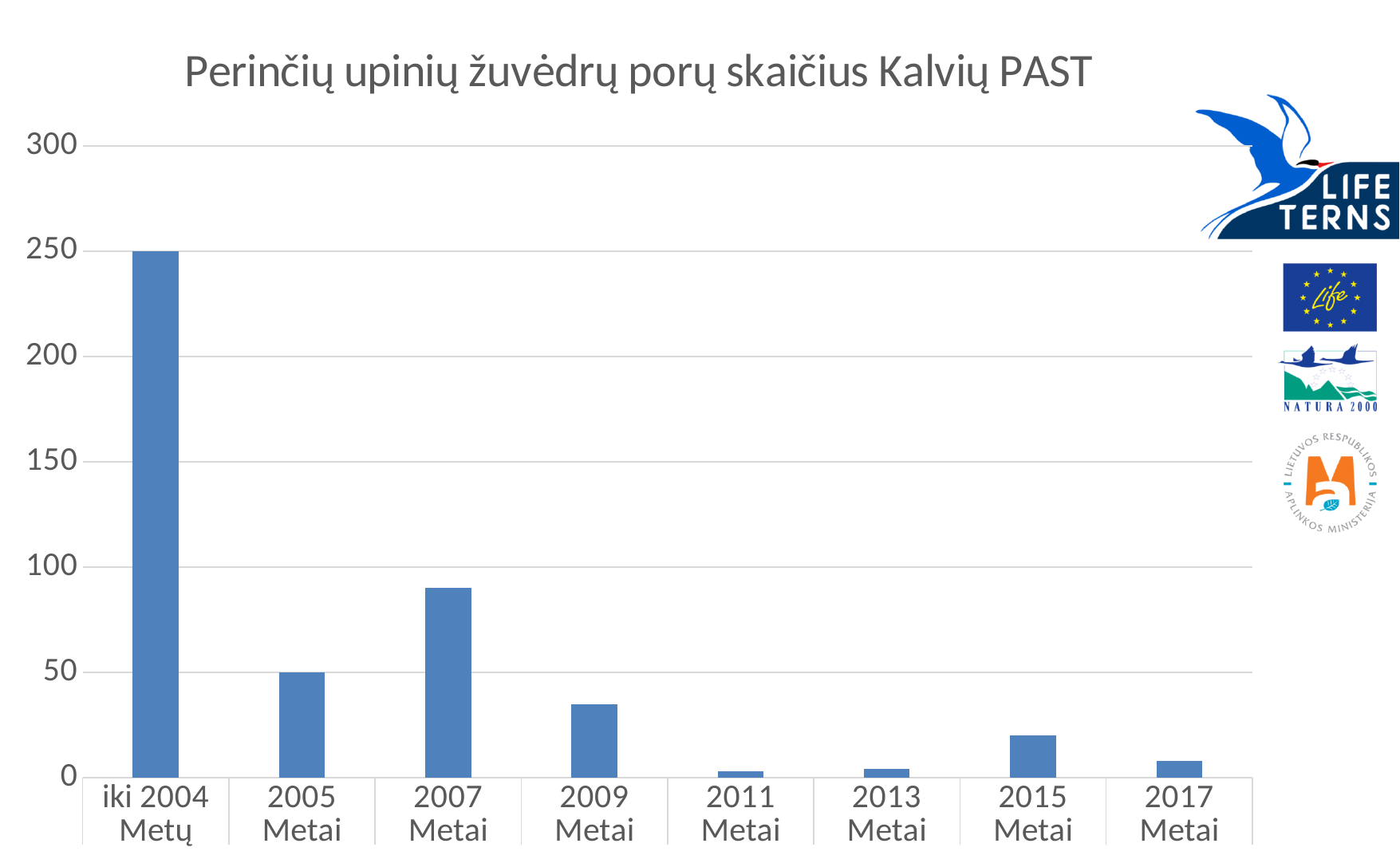
Which category has the highest value? iki 2004 Metų Is the value for "2007 Metai" greater or less than 100? less How many categories are shown on the x axis of the chart? 8 What type of chart is shown on the slide? bar chart Which is larger, the value for "2007 Metai" or the value for "2009 Metai"? 2007 Metai What is the difference between the values for "iki 2004 Metų" and "2005 Metai"? 200 What is the value for "2005 Metai"? 50 Is the value for "2007 Metai" greater or less than 50? greater What is the title of the chart? Perinčių upinių žuvėdrų porų skaičius Kalvių PAST What is the value for "iki 2004 Metų"? 250 Overall, do the values rise or fall from "iki 2004 Metų" to "2017 Metai"? fall Is the value for "2009 Metai" greater or less than 50? less